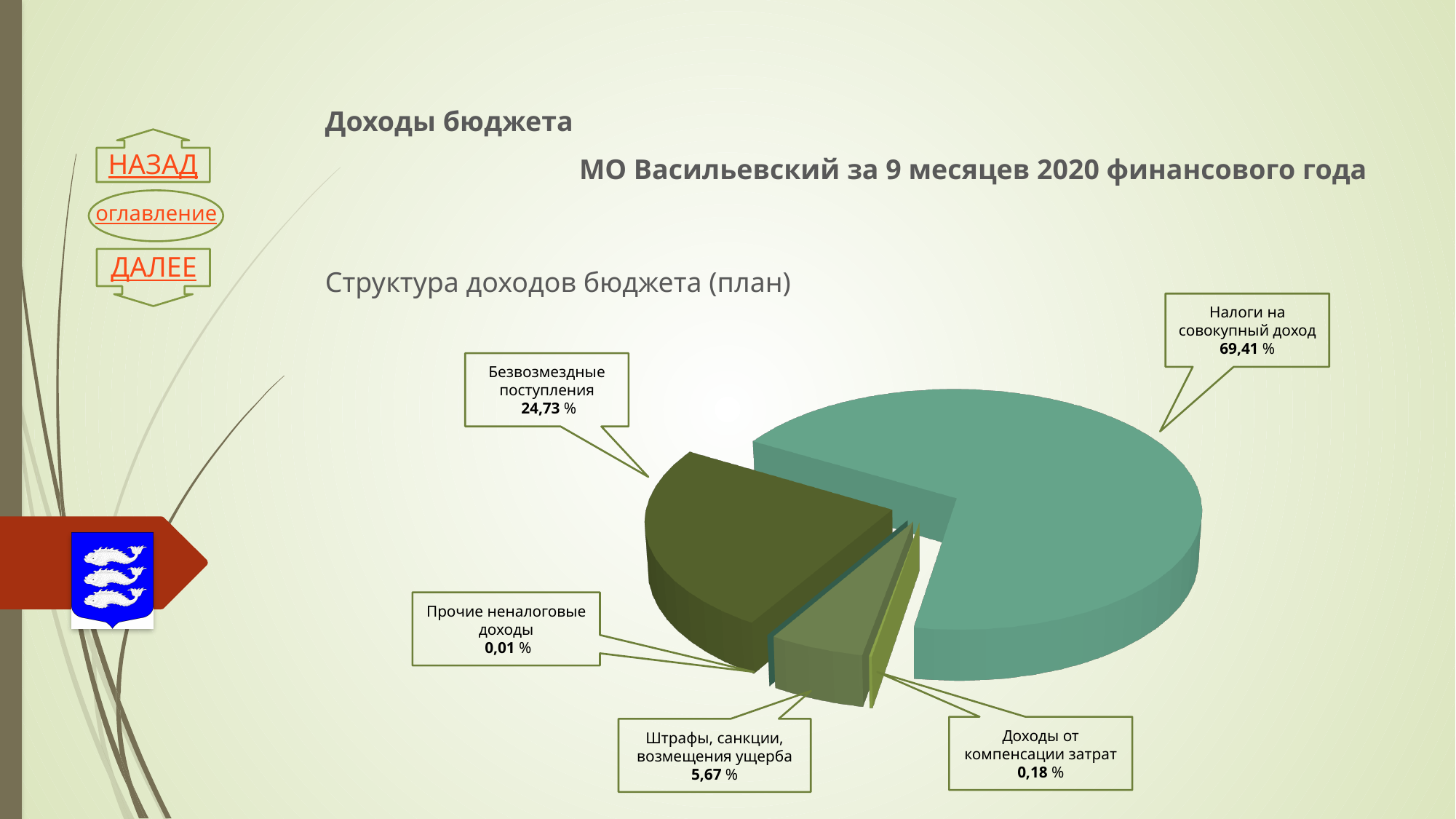
What is the value for Доходы от компенсации затрат? 0,18 % What percentage is labelled for Штрафы, санкции, возмещения ущерба? 5,67 % What type of chart is shown on the slide? Pie chart How many slices does the pie chart have? 5 Which category has the smallest share of the pie? Прочие неналоговые доходы What share of the pie does Налоги на совокупный доход have? 69,41 % What is the value shown for Безвозмездные поступления? 24,73 % Which category has the largest share of the pie? Налоги на совокупный доход Which is larger: Безвозмездные поступления or Штрафы, санкции, возмещения ущерба? Безвозмездные поступления What is the value for Прочие неналоговые доходы? 0,01 % What is the difference between the shares of Налоги на совокупный доход and Безвозмездные поступления? 44,68 % What is the title of the chart? Структура доходов бюджета (план)